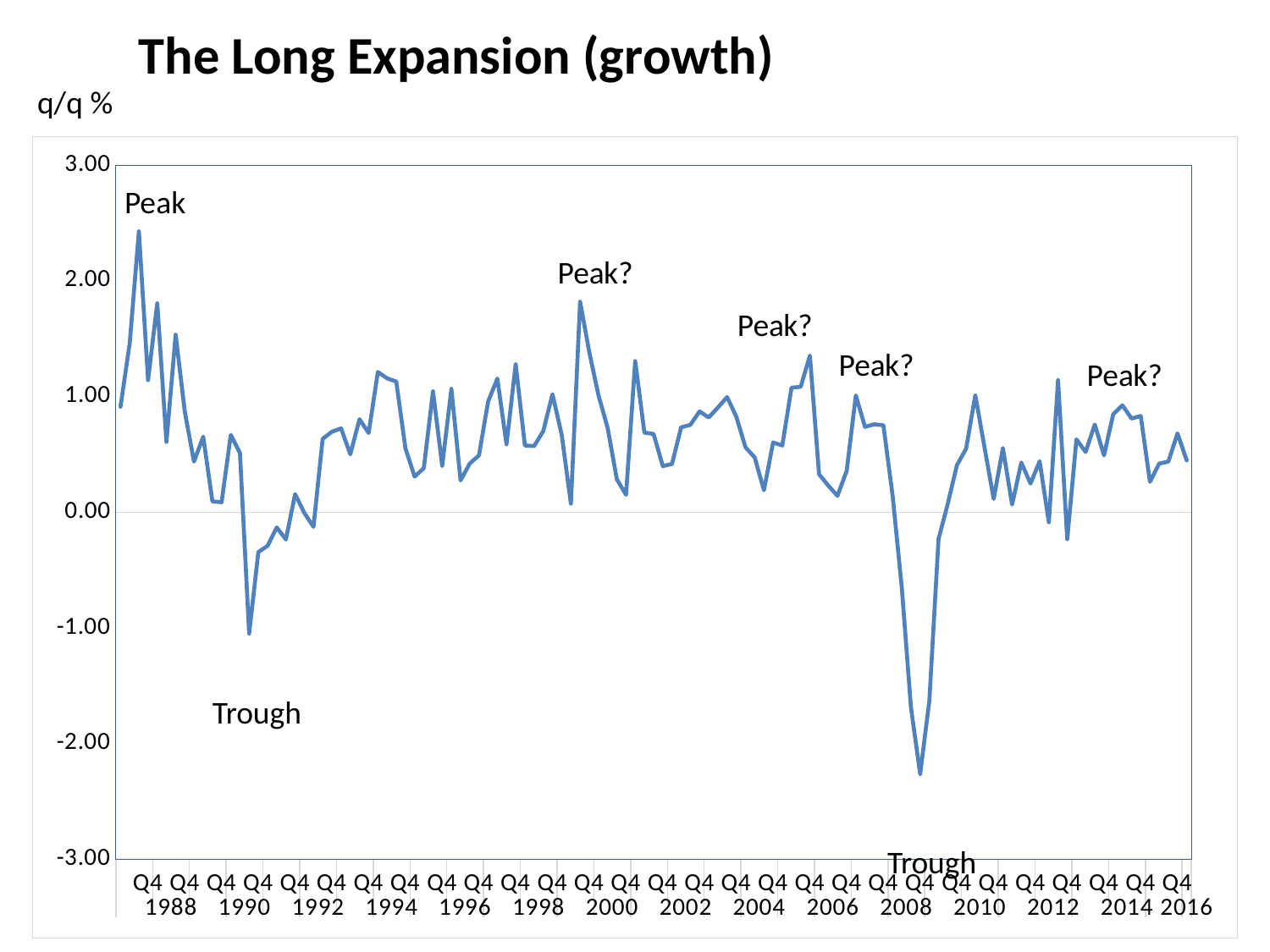
Which is higher: the peak near 1988 or the peak near 1999? the peak near 1988 Is the value at the point labelled "Trough" near 1990 greater or less than 0.00? less Is the value at the point labelled "Trough" near 2008-2009 greater or less than -2.00? less Around which year does the line reach its highest value? 1987 Around which year does the line reach its lowest value? 2008 Between the "Peak" label near 1988 and the "Trough" label near 1990, does the line generally rise or fall? fall What unit label is shown above the vertical axis of the chart? q/q % Is the value at the point labelled "Peak?" near 2005 greater or less than 1.00? greater What kind of chart is shown on the slide? line chart What is the title of the chart? The Long Expansion (growth)